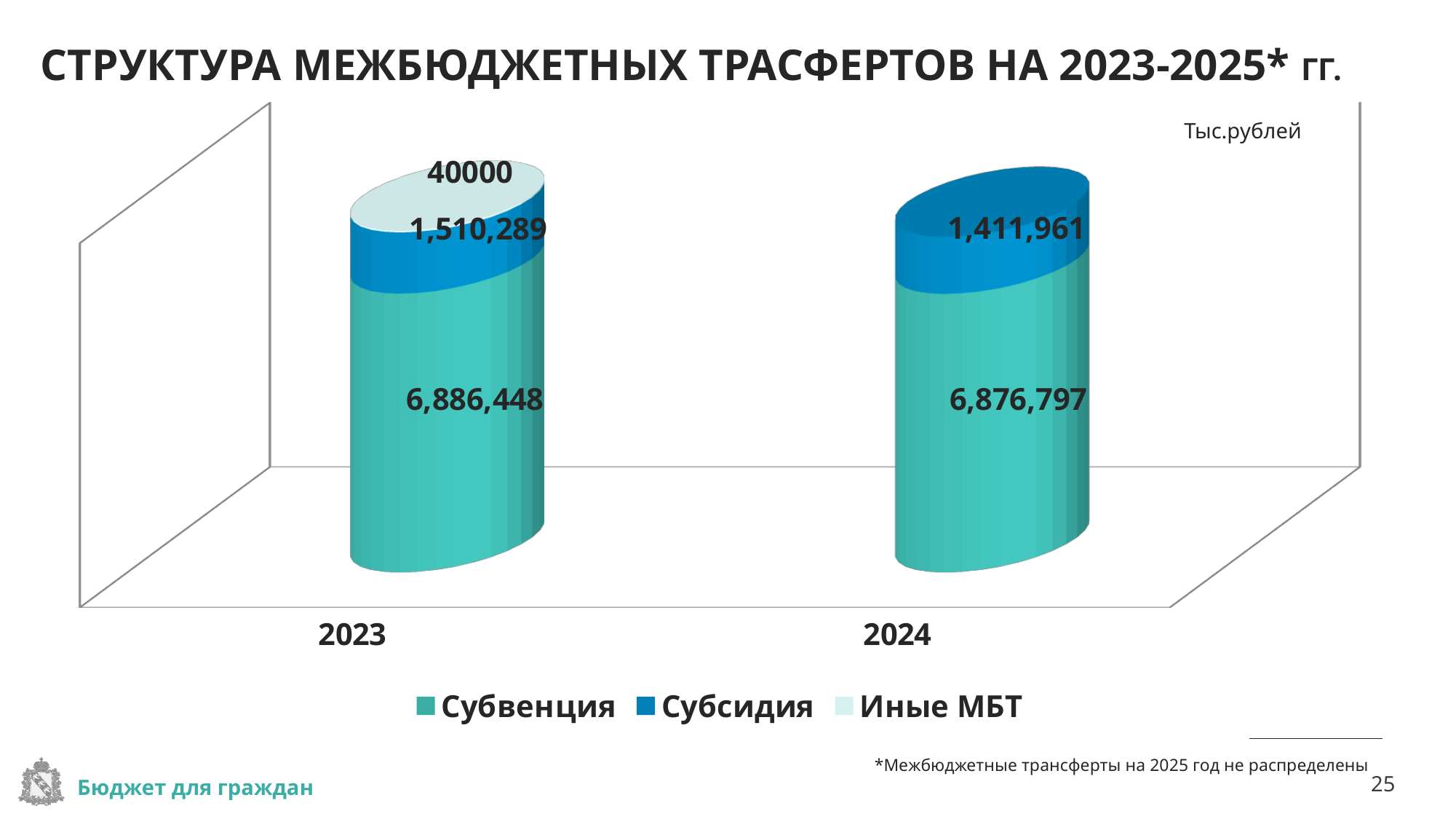
In what units are the values on the chart expressed, according to the note in the top right? Тыс.рублей What type of chart is shown on the slide? bar chart What is the difference between the Субвенция values for 2023 and 2024? 9,651 What is the value of Субвенция for 2023? 6,886,448 What is the total of the stacked bar for 2023? 8,436,737 Which year has the higher value for Субсидия, 2023 or 2024? 2023 What is the value of Субсидия for 2024? 1,411,961 What is the value of Субвенция for 2024? 6,876,797 How many years (categories) are plotted on the x axis? 2 What is the difference between the Субсидия values for 2023 and 2024? 98,328 What is the value of Иные МБТ for 2023? 40000 How many series does the legend list? 3